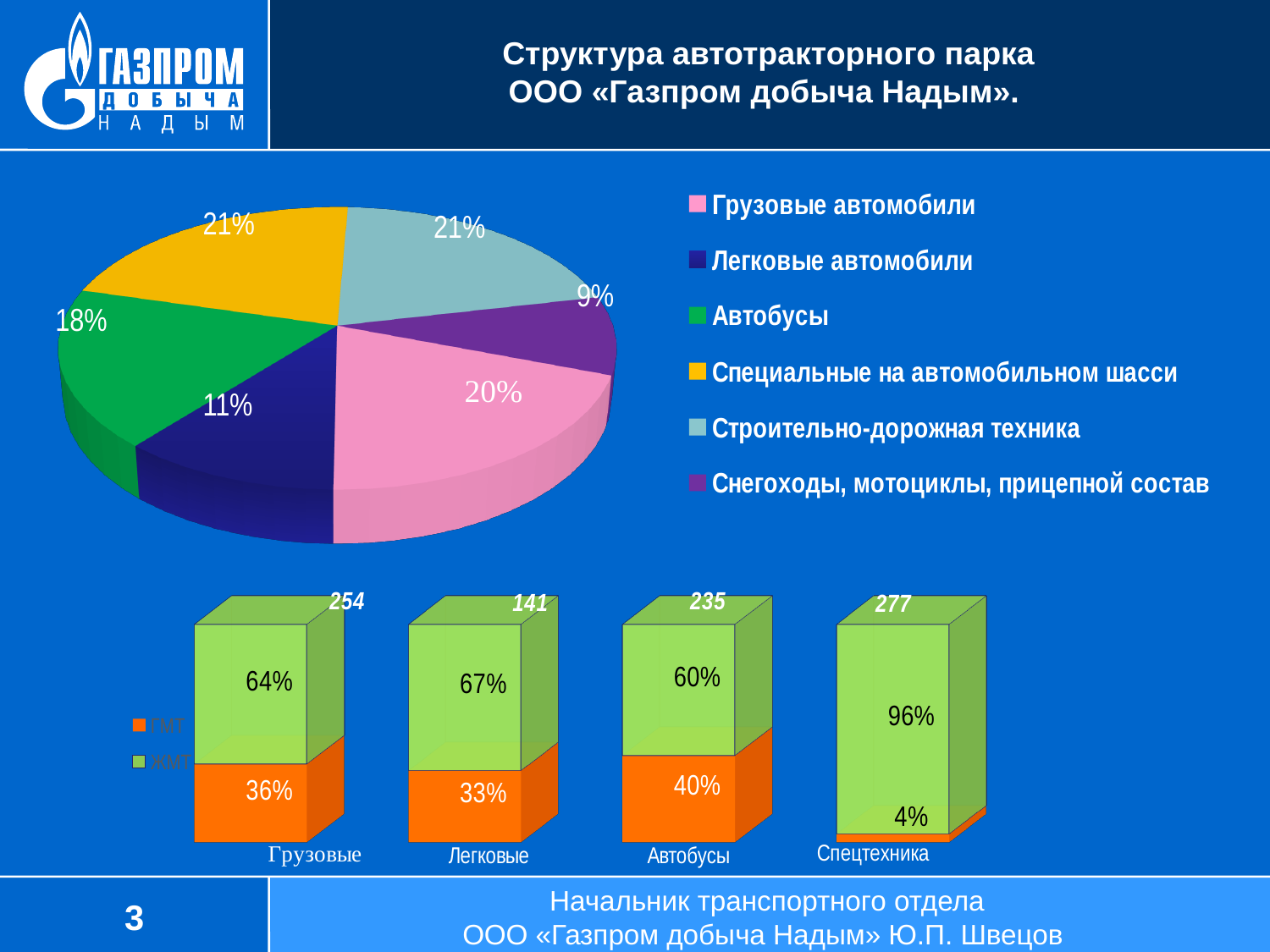
In the pie chart at the top of the slide, what share is shown for Снегоходы, мотоциклы, прицепной состав? 9% In the pie chart at the top of the slide, what share is shown for Легковые автомобили? 11% In the bar chart at the bottom of the slide, how many categories are shown on the x axis? 4 In the pie chart at the top of the slide, which is larger: the share for Автобусы or the share for Легковые автомобили? Автобусы In the bar chart at the bottom of the slide, what total is printed above the Спецтехника bar? 277 In the bar chart at the bottom of the slide, which category has the lowest total printed above its bar? Легковые In the pie chart at the top of the slide, what is the difference in percentage points between the share for Грузовые автомобили and the share for Легковые автомобили? 9 What kind of chart is shown at the bottom of the slide? Stacked bar chart In the bar chart at the bottom of the slide, what is the difference between the totals printed for Грузовые and Автобусы? 19 In the pie chart at the top of the slide, how many categories does the legend list? 6 In the bar chart at the bottom of the slide, what percentage is shown for the orange segment of the Автобусы bar? 40% In the pie chart at the top of the slide, which category has the smallest share? Снегоходы, мотоциклы, прицепной состав